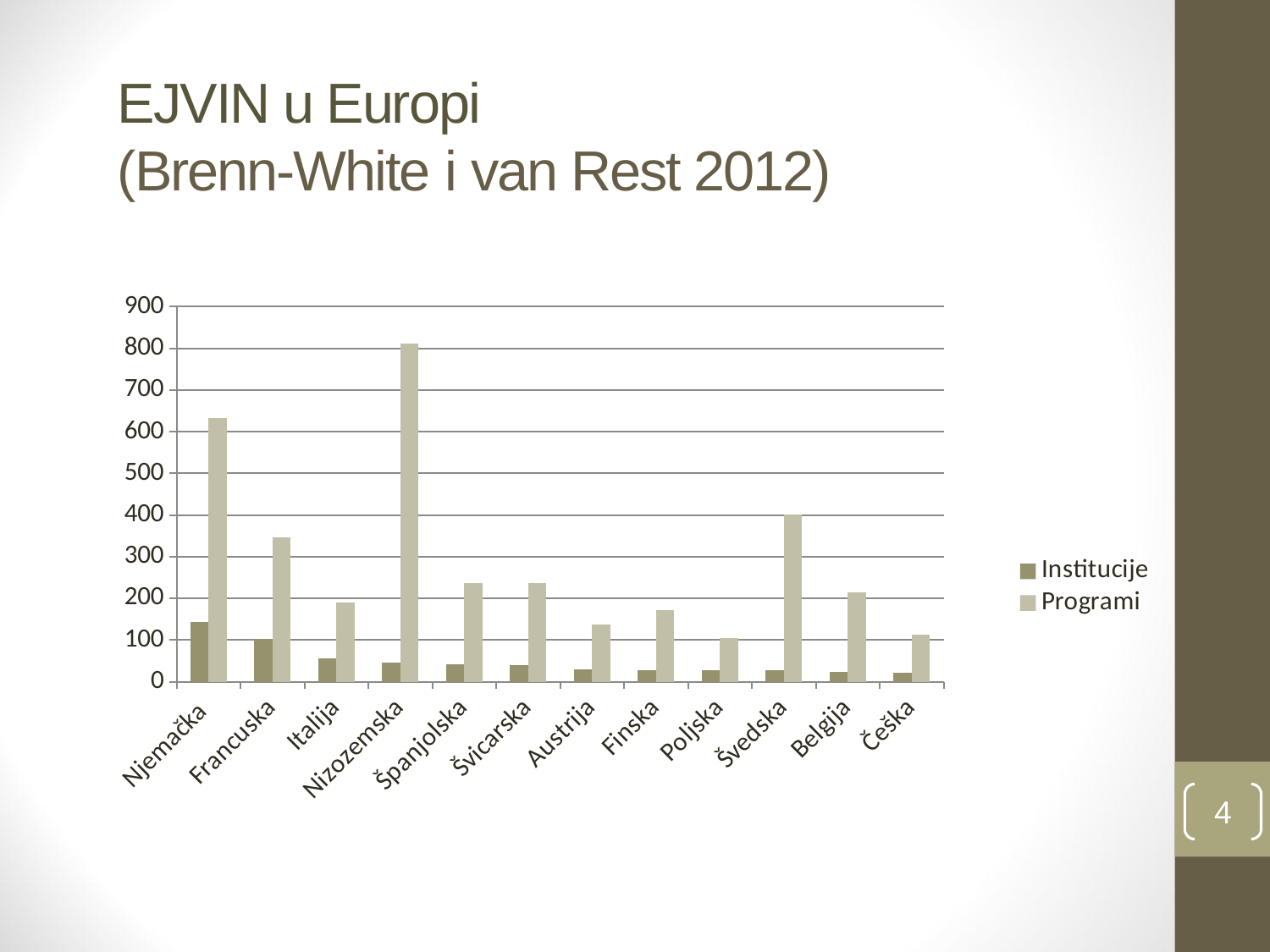
What kind of chart is shown on the slide? bar chart How many series does the chart legend list? 2 Which is larger, the Programi value for Njemačka or for Francuska? Njemačka Which is larger, the Programi value for Švedska or for Belgija? Švedska Which country has the highest value for Institucije? Njemačka Which country has the highest value for Programi? Nizozemska How many countries are shown on the x axis of the chart? 12 Is the Programi value for Njemačka greater or less than 600? greater Is the Programi value for Nizozemska greater or less than 800? greater What are the two series named in the chart legend? Institucije and Programi Is the Institucije value for Njemačka greater or less than 100? greater